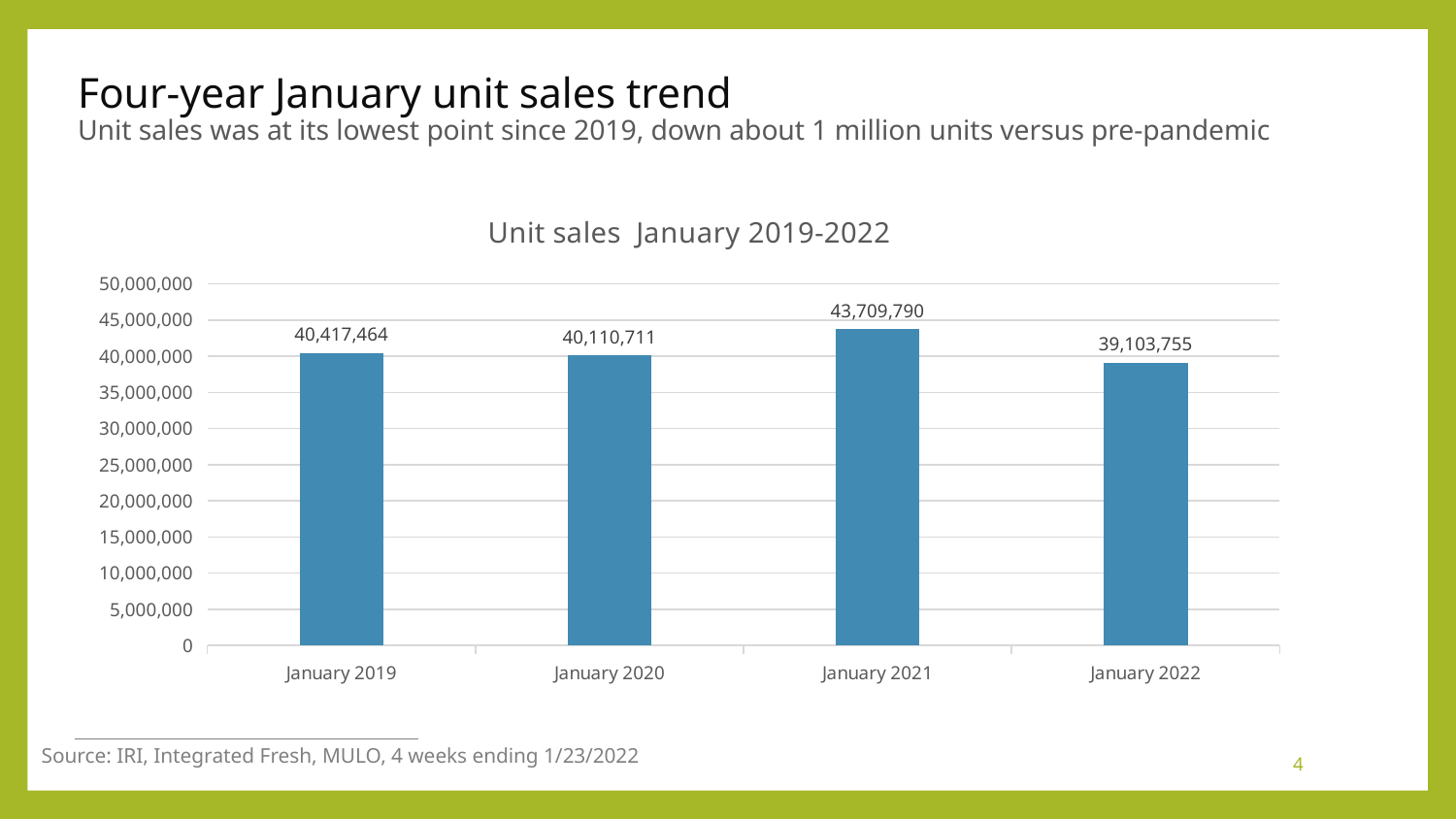
What is the title of the chart? Unit sales January 2019-2022 How many categories are shown on the x axis? 4 What is the difference in unit sales between January 2021 and January 2022? 4,606,035 Which is larger, unit sales in January 2019 or January 2020? January 2019 Which January has the highest unit sales? January 2021 What is the difference in unit sales between January 2019 and January 2022? 1,313,709 What is the unit sales value for January 2022? 39,103,755 What kind of chart is shown on the slide? bar chart What is the unit sales value for January 2021? 43,709,790 What is the unit sales value for January 2019? 40,417,464 Which January has the lowest unit sales? January 2022 Is the value for January 2022 greater or less than 40,000,000? less